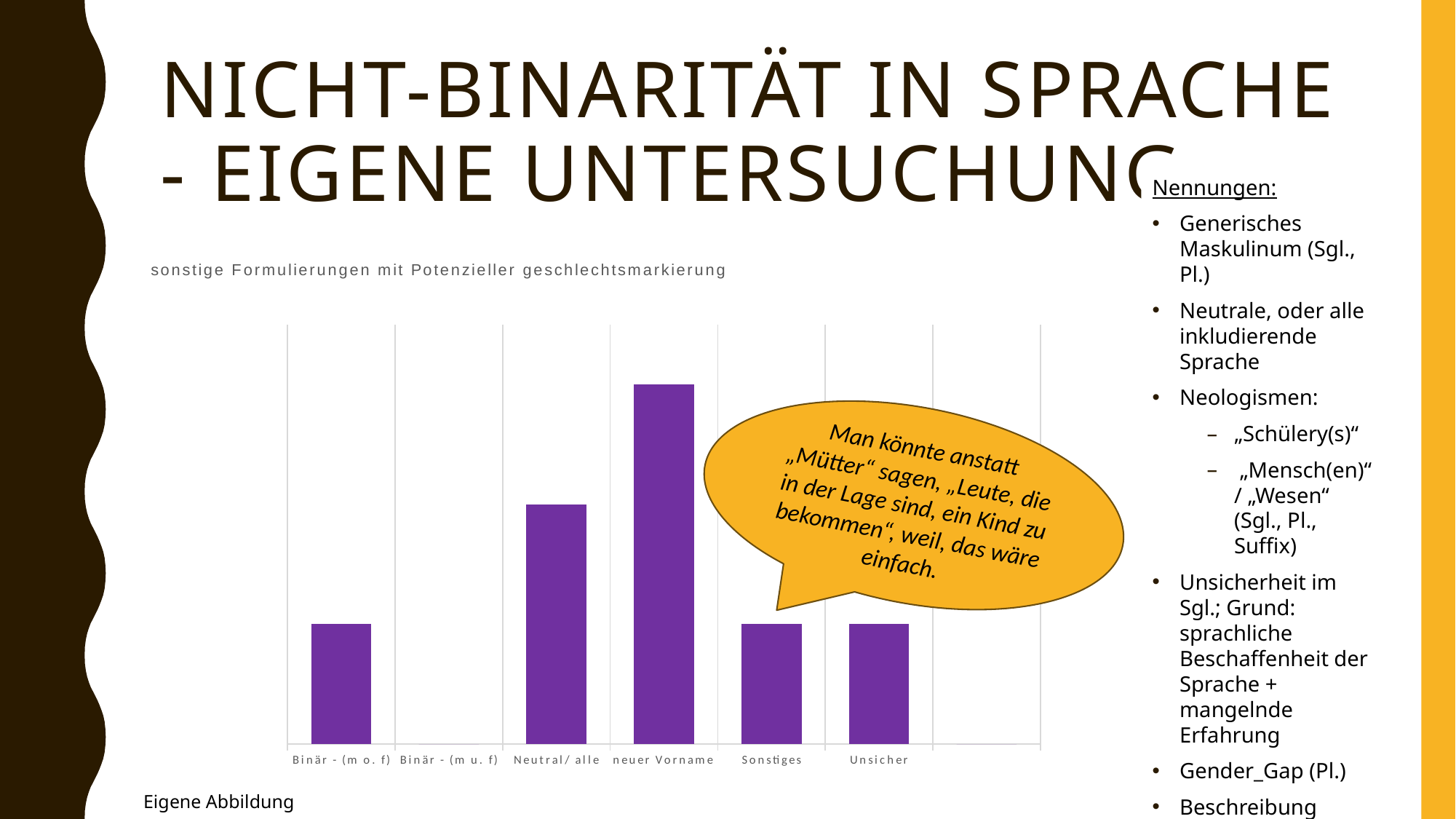
Which is larger, the bar for neuer Vorname or the bar for Neutral/ alle? neuer Vorname How many categories are shown on the x axis of the chart? 6 Which is larger, the bar for Neutral/ alle or the bar for Sonstiges? Neutral/ alle What kind of chart is shown on the slide? bar chart What is the label of the first category on the x axis? Binär - (m o. f) Which category has no visible bar in the chart? Binär - (m u. f) Which is larger, the bar for Unsicher or the bar for neuer Vorname? neuer Vorname What is the title of the chart? sonstige Formulierungen mit Potenzieller geschlechtsmarkierung Which category has the second-highest bar in the chart? Neutral/ alle What colour are the bars in the chart? purple Which category has the highest bar in the chart? neuer Vorname